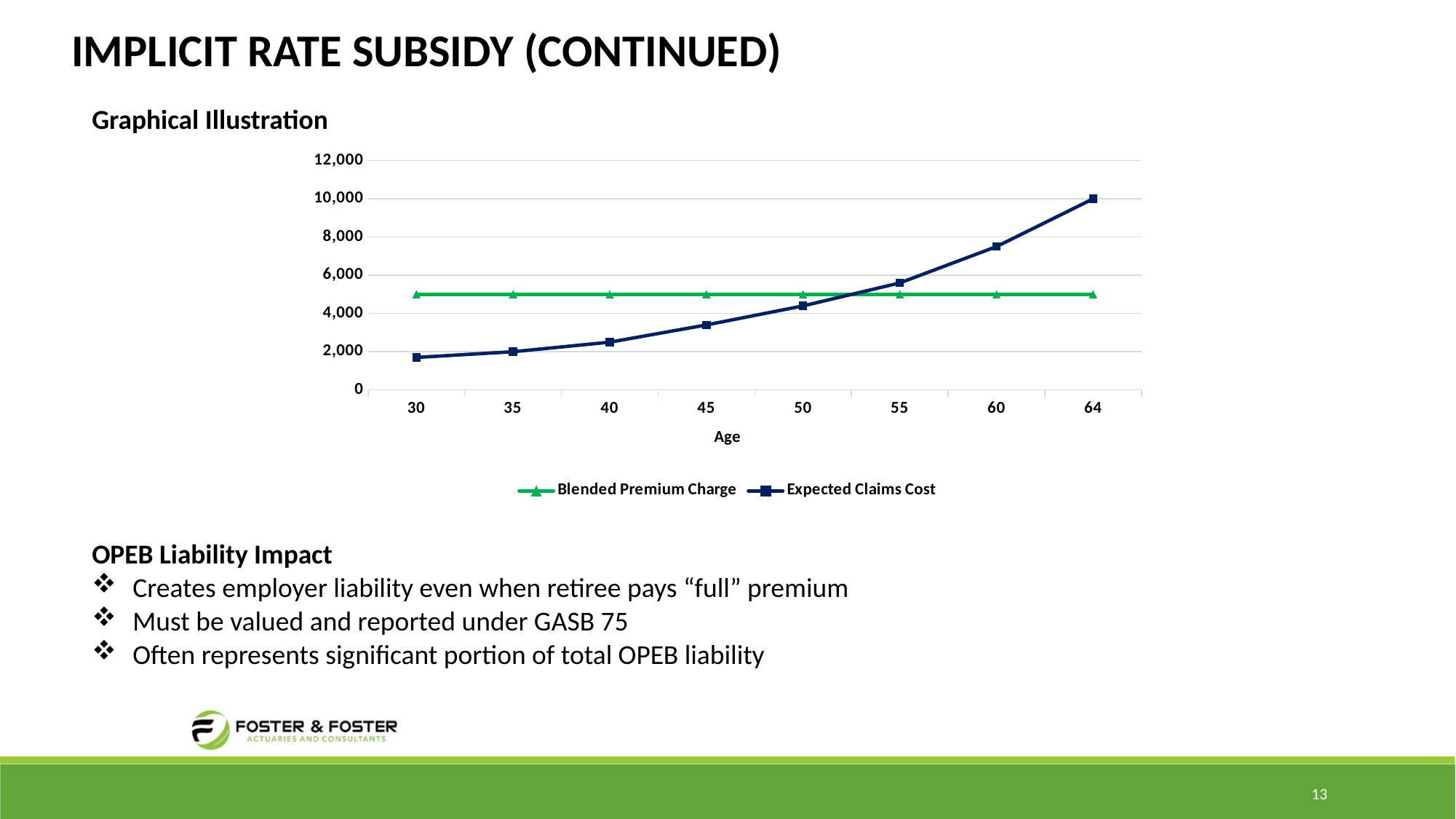
Does the Expected Claims Cost rise or fall as age increases? rise At age 64, which is larger: the Blended Premium Charge or the Expected Claims Cost? Expected Claims Cost How many series does the chart legend list? 2 At age 30, which is larger: the Blended Premium Charge or the Expected Claims Cost? Blended Premium Charge At which age is the Expected Claims Cost lowest? 30 What kind of chart is shown on the slide? line chart How many age points are plotted along the x axis? 8 At which age is the Expected Claims Cost highest? 64 Is the Blended Premium Charge greater or less than 4,000? greater Is the Expected Claims Cost at age 60 greater or less than 8,000? less What is the Expected Claims Cost at age 64? 10,000 Is the Expected Claims Cost at age 30 greater or less than 2,000? less